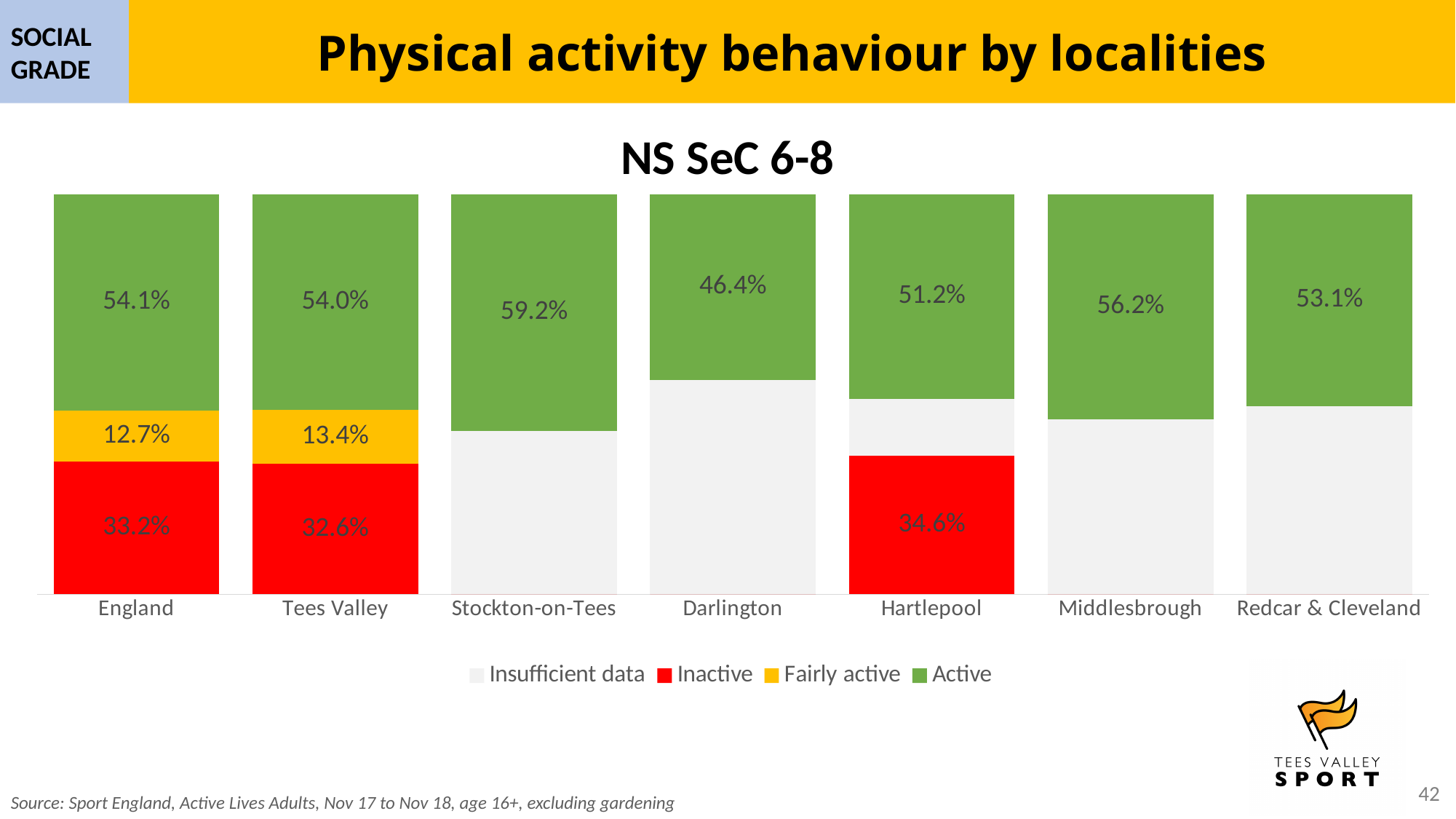
Which locality has the lowest Active value? Darlington Which has the larger Inactive value, England or Hartlepool? Hartlepool Which locality has the highest Active value? Stockton-on-Tees What is the Fairly active value for Tees Valley? 13.4% What is the total of the Inactive, Fairly active and Active values for England? 100.0% What is the Active value for Stockton-on-Tees? 59.2% What is the title of the chart? NS SeC 6-8 What kind of chart is shown? Stacked bar chart What is the Inactive value for Hartlepool? 34.6% What is the difference between the Active values for Stockton-on-Tees and Darlington? 12.8% How many series does the legend list? 4 How many localities are shown on the x axis? 7